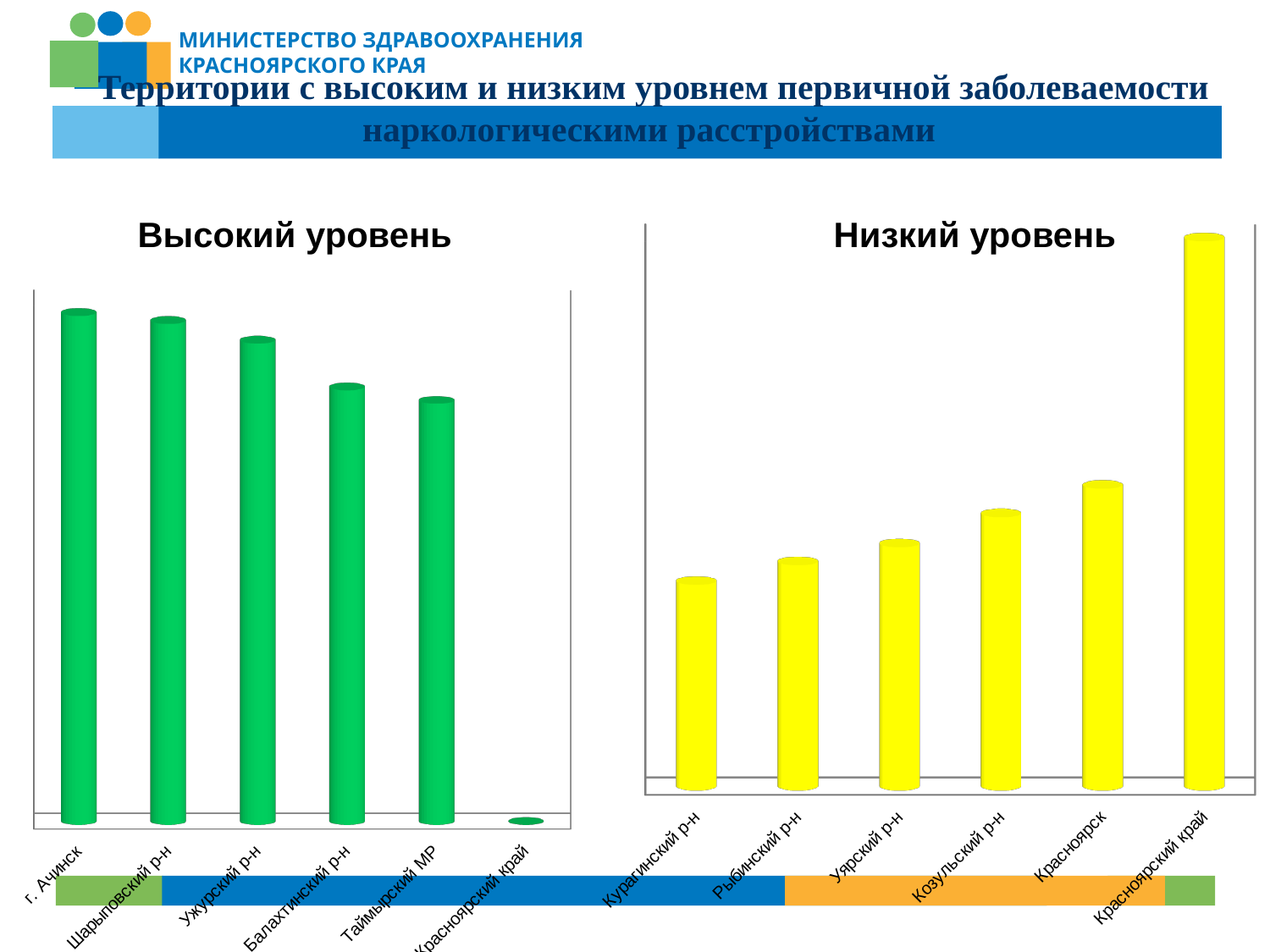
How many categories are shown in the "Высокий уровень" chart? 6 In the "Низкий уровень" chart, which category has the highest value? Красноярский край In the "Высокий уровень" chart, which category has the lowest value? Красноярский край What colour are the bars in the "Низкий уровень" chart? Yellow What kind of chart is the "Высокий уровень" chart on the left? Bar chart In the "Высокий уровень" chart, which is larger: г. Ачинск or Балахтинский р-н? г. Ачинск In the "Низкий уровень" chart, which category has the lowest value? Курагинский р-н How many categories are shown in the "Низкий уровень" chart? 6 In the "Низкий уровень" chart, do the values rise or fall from left to right across the categories? Rise In the "Высокий уровень" chart, do the values rise or fall from left to right across the categories? Fall In the "Высокий уровень" chart, which is larger: Ужурский р-н or Таймырский МР? Ужурский р-н What kind of chart is the "Низкий уровень" chart on the right? Bar chart